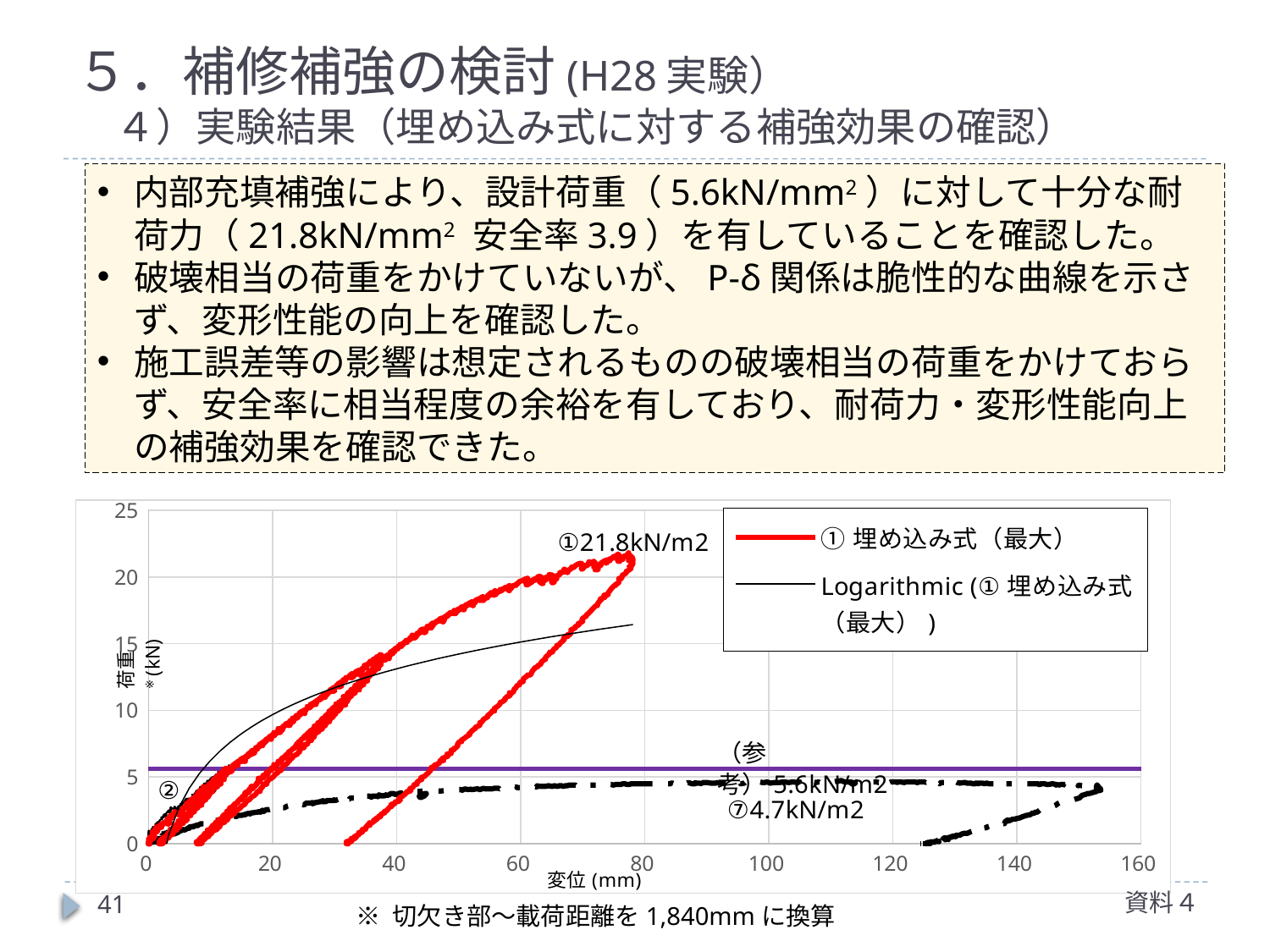
What value is labelled for the reference (参考) horizontal line? 5.6kN/m2 What maximum load value is labelled for series ① 埋め込み式（最大）? 21.8kN/m2 What colour is the line for ① 埋め込み式（最大） in the legend? red What is the difference between the reference value (5.6kN/m2) and the labelled value of ⑦ (4.7kN/m2)? 0.9kN/m2 What kind of chart is shown on the slide? line chart What value is labelled for series ⑦? 4.7kN/m2 Is the peak load of series ① greater or less than 20 on the y axis? greater What is the title of the x axis? 変位 (mm) What is the difference between the labelled maximum of ① (21.8kN/m2) and the reference value (5.6kN/m2)? 16.2kN/m2 Is the peak load of series ⑦ greater or less than 10 on the y axis? less Which reaches a higher load, series ① or series ⑦? ① How many series does the chart legend list? 2